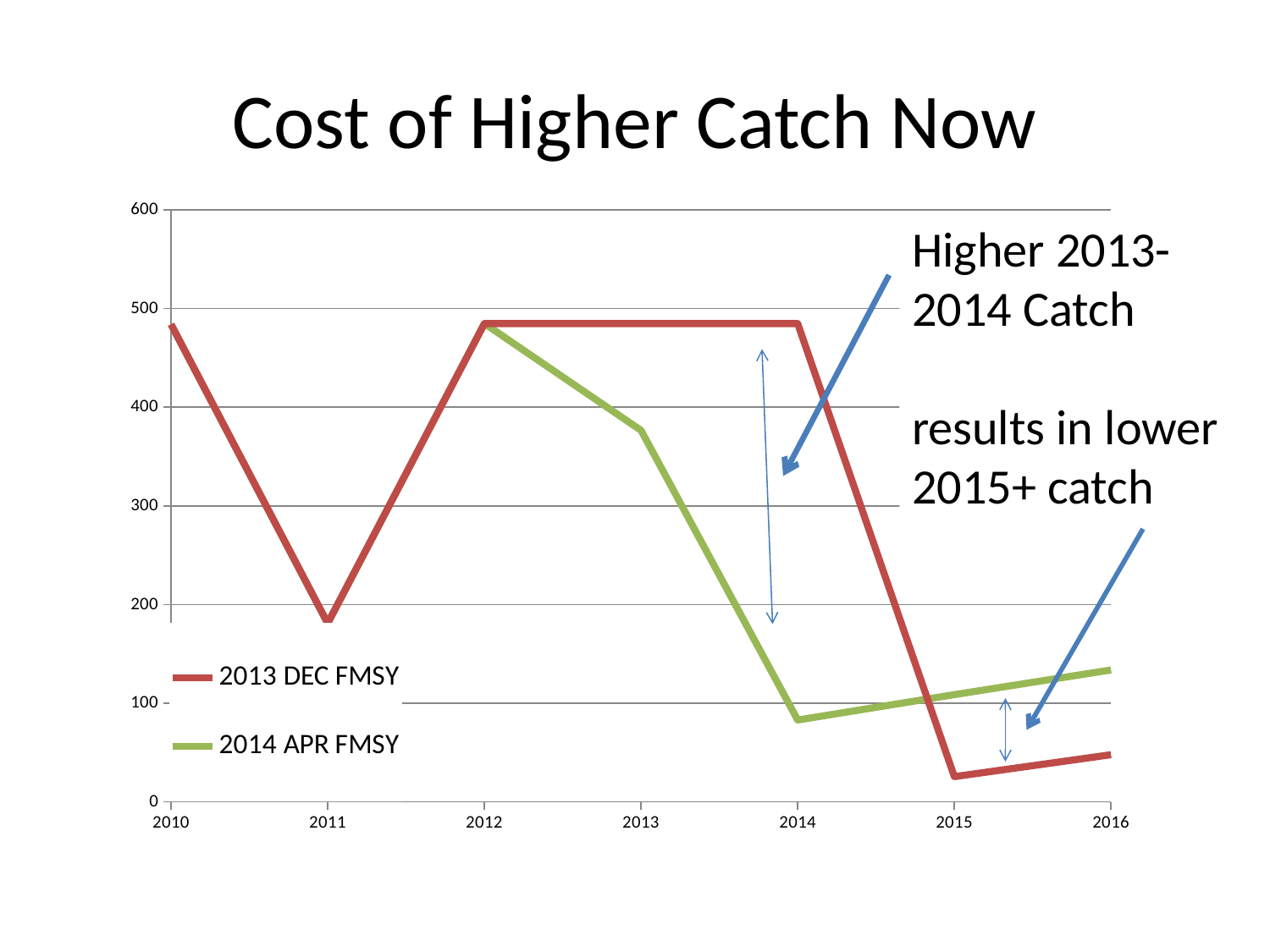
How many series does the legend list? 2 Is the value for 2013 DEC FMSY in 2014 greater or less than 400? greater Is the value for 2013 DEC FMSY in 2011 greater or less than 200? less In 2014, which series has the higher value, 2013 DEC FMSY or 2014 APR FMSY? 2013 DEC FMSY How many years are labelled on the x axis? 7 What kind of chart is shown on the slide? line chart In 2016, which series has the higher value, 2013 DEC FMSY or 2014 APR FMSY? 2014 APR FMSY Is the value for 2014 APR FMSY in 2014 greater or less than 100? less What are the two series named in the legend? 2013 DEC FMSY and 2014 APR FMSY What is the title of the chart slide? Cost of Higher Catch Now In which year does the 2013 DEC FMSY series reach its lowest value? 2015 Does the 2013 DEC FMSY line rise or fall from 2014 to 2015? fall